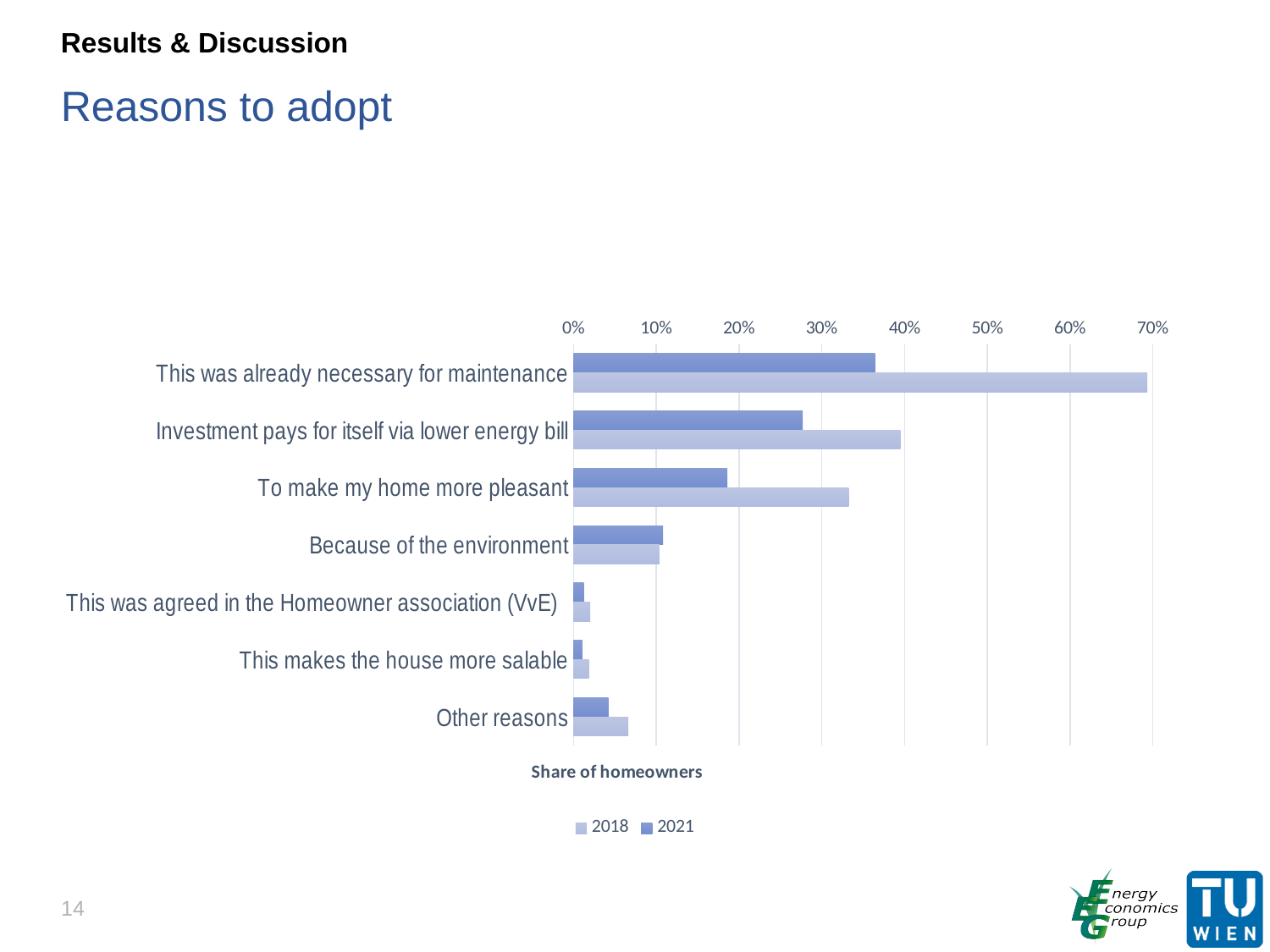
What is the title of the horizontal axis of the chart? Share of homeowners Is the 2018 value for 'This was already necessary for maintenance' greater or less than 60%? greater For 'Investment pays for itself via lower energy bill', which year has the larger share of homeowners, 2018 or 2021? 2018 Which reason has the highest share of homeowners in 2021? This was already necessary for maintenance Is the 2021 value for 'This was already necessary for maintenance' greater or less than 40%? less Is the 2021 value for 'Investment pays for itself via lower energy bill' greater or less than 30%? less What kind of chart is shown on the slide? bar chart How many series does the legend list? 2 How many reasons (categories) are plotted on the chart? 7 Which reason has the highest share of homeowners in 2018? This was already necessary for maintenance Which is larger: the 2018 value for 'Other reasons' or the 2018 value for 'This makes the house more salable'? Other reasons